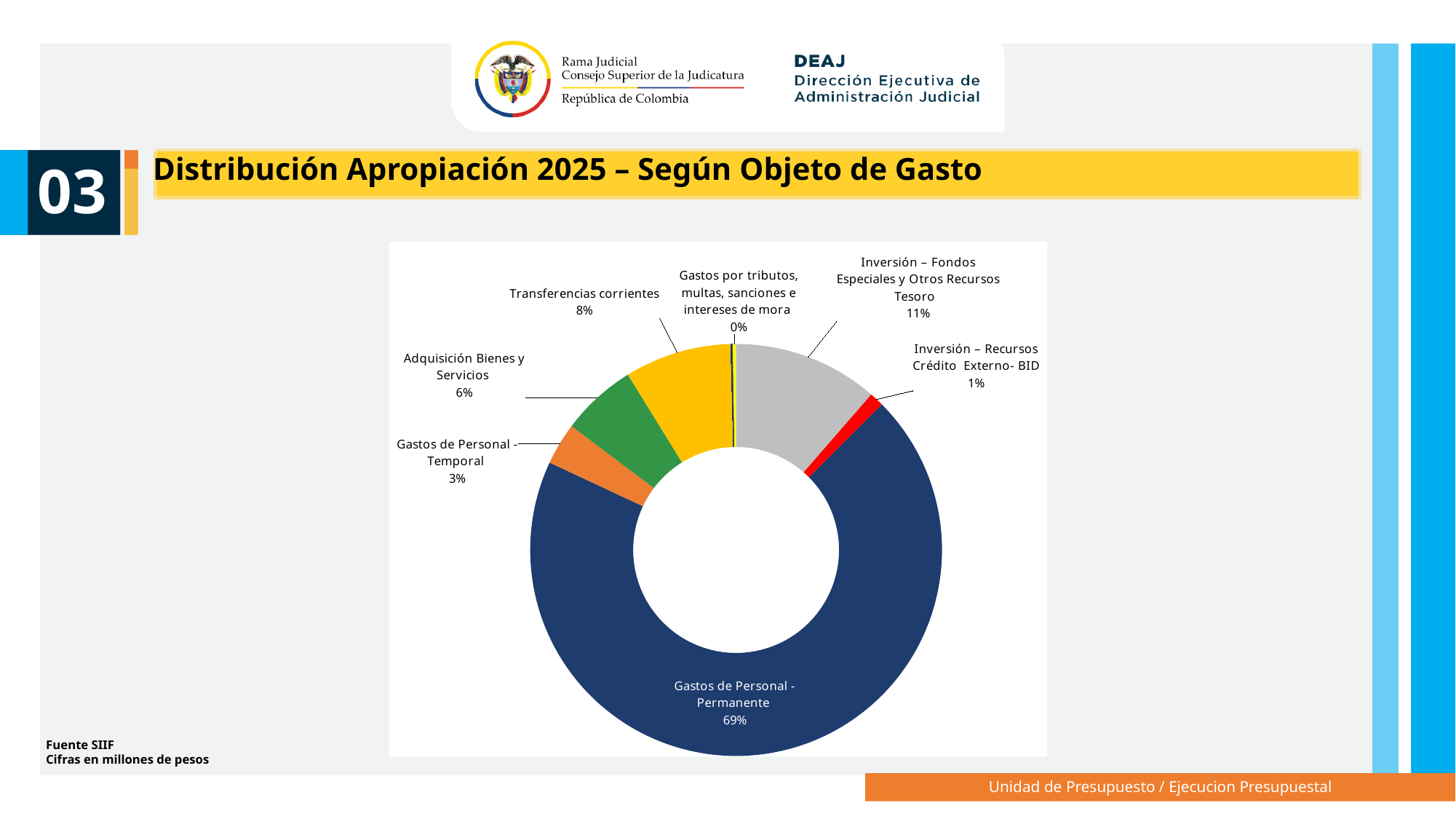
What percentage is shown for Adquisición Bienes y Servicios? 6% Which category has the largest share of the chart? Gastos de Personal - Permanente Which is larger, Transferencias corrientes or Gastos de Personal - Temporal? Transferencias corrientes What percentage is shown for Inversión – Recursos Crédito Externo- BID? 1% What percentage is shown for Inversión – Fondos Especiales y Otros Recursos Tesoro? 11% How many percentage points larger is Gastos de Personal - Permanente than Inversión – Fondos Especiales y Otros Recursos Tesoro? 58 percentage points What kind of chart is shown on the slide? Doughnut (pie) chart How many categories are shown in the chart? 8 What colour is the Gastos de Personal - Permanente segment? Dark blue What share of the 2025 appropriation goes to Gastos de Personal - Permanente? 69% What percentage is shown for Transferencias corrientes? 8%